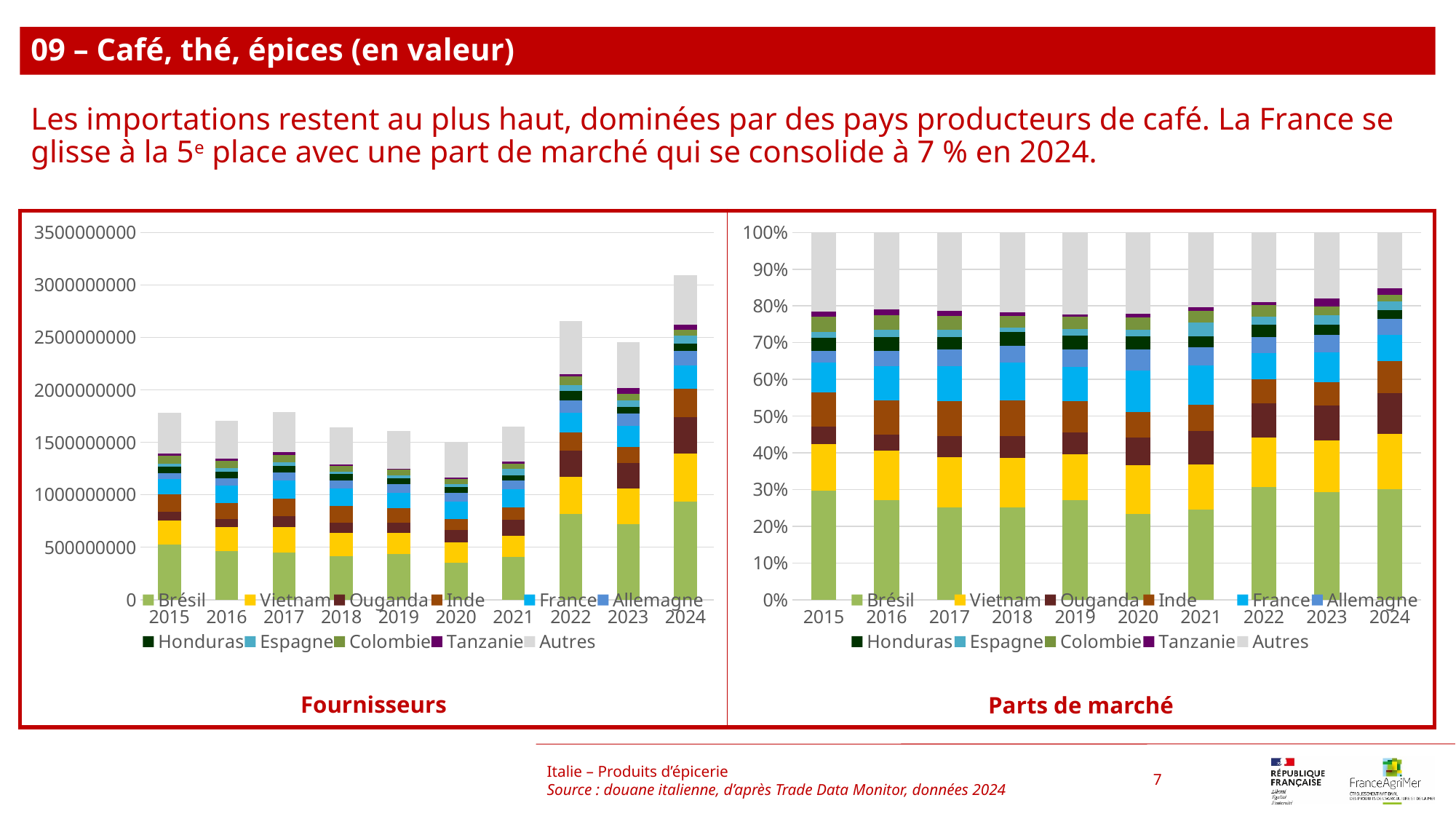
In the Fournisseurs chart, which year has the highest total bar? 2024 In the Parts de marché chart, is the share for Brésil in 2020 greater or less than 30%? less In the Fournisseurs chart, which year has the lowest total bar? 2020 In the Fournisseurs chart, is the total for 2024 greater or less than 3000000000? greater In the legend of the Fournisseurs chart, which series is shown in yellow? Vietnam In the Fournisseurs chart, does the total rise or fall from 2021 to 2022? rise What kind of chart is the Fournisseurs chart on the left? stacked bar chart In the Fournisseurs chart, which year has the larger total bar, 2022 or 2023? 2022 What is the title shown under the right-hand chart? Parts de marché In the Fournisseurs chart, is the total for 2015 greater or less than 2000000000? less How many series does the legend of the Parts de marché chart list? 11 How many years are shown on the x axis of the Fournisseurs chart? 10